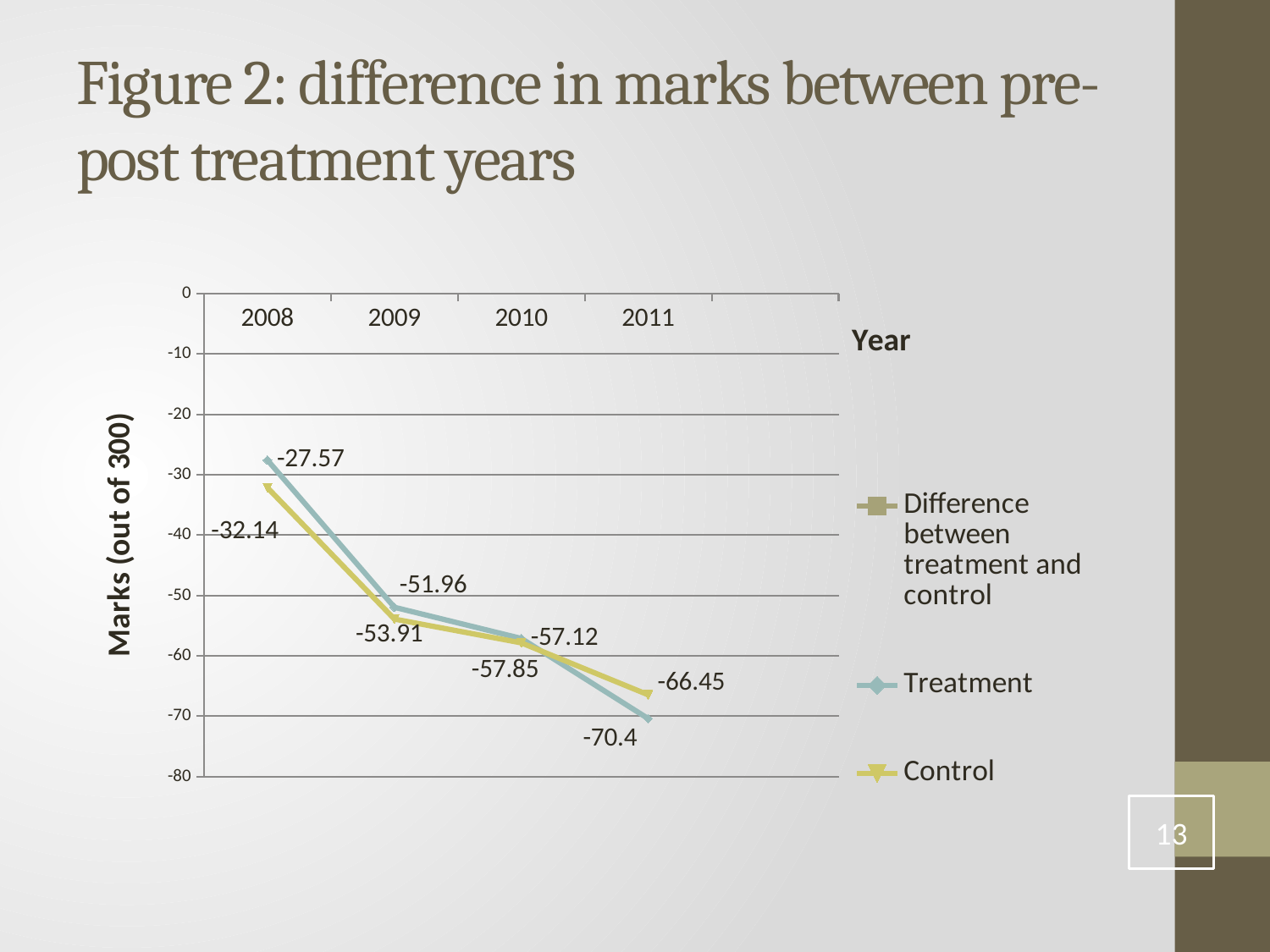
What is the Control value for 2009? -53.91 In which year is the Control value highest? 2008 Do the Treatment values rise or fall from 2008 to 2011? fall What is the difference between the Treatment and Control values in 2011? 3.95 In which year is the Treatment value lowest? 2011 What is the Treatment value for 2010? -57.12 In 2008, which series has the higher value, Treatment or Control? Treatment How many years are shown on the x axis? 4 What is the Control value for 2011? -66.45 How many series does the legend list? 3 What is the Treatment value for 2008? -27.57 What is the difference between the Treatment values for 2008 and 2011? 42.83